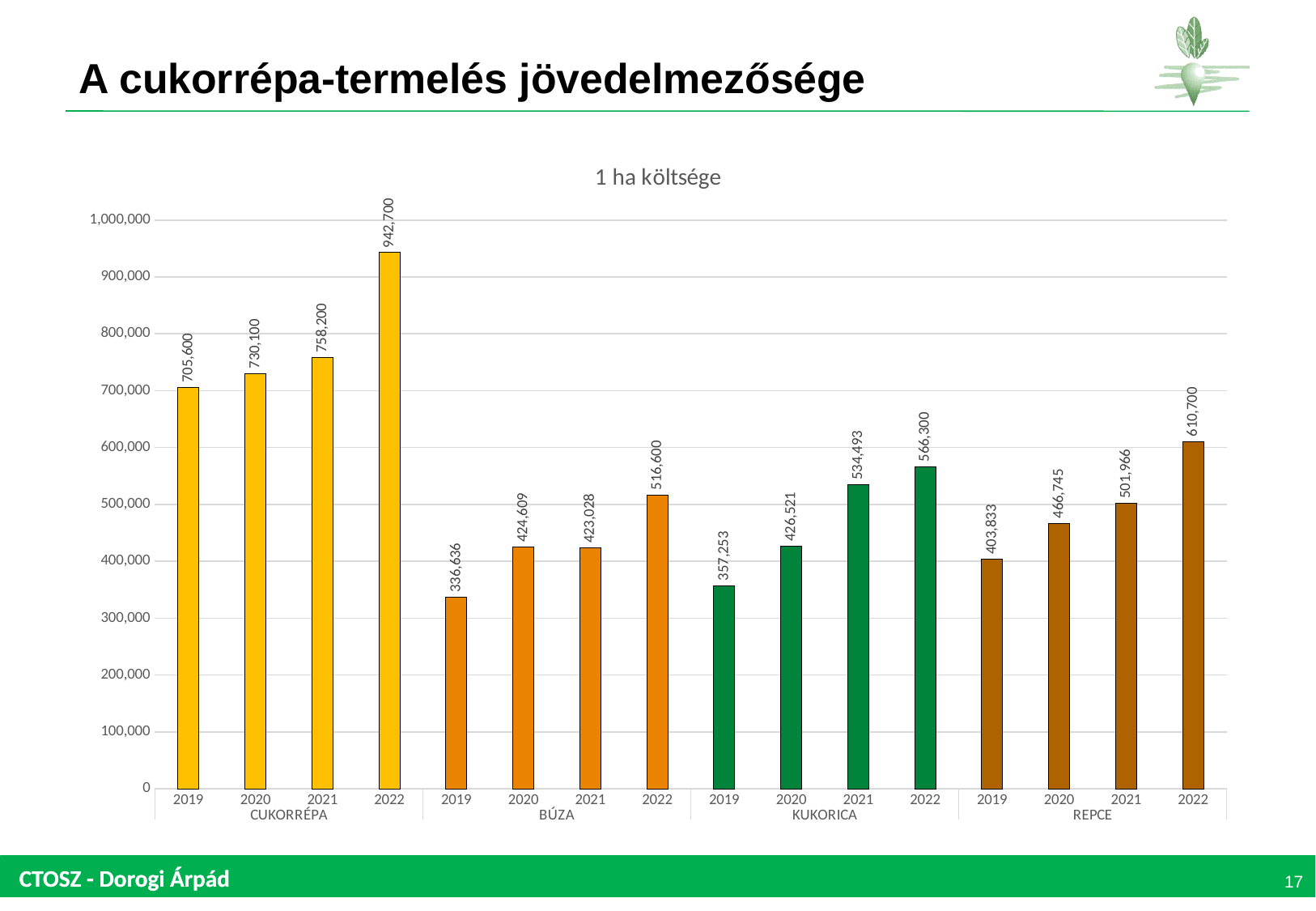
What is the value for BÚZA in 2019? 336,636 What is the value for CUKORRÉPA in 2022? 942,700 What is the title of the chart? 1 ha költsége What is the difference between the CUKORRÉPA values for 2022 and 2021? 184,500 What is the value for REPCE in 2020? 466,745 Is the value for REPCE in 2019 greater or less than 500,000? less What is the value for KUKORICA in 2021? 534,493 Which bar has the highest value in the chart? CUKORRÉPA 2022 What kind of chart is shown on the slide? bar chart Which bar has the lowest value in the chart? BÚZA 2019 How many bars are plotted in the chart? 16 Which is larger, the KUKORICA value for 2022 or the REPCE value for 2022? REPCE 2022